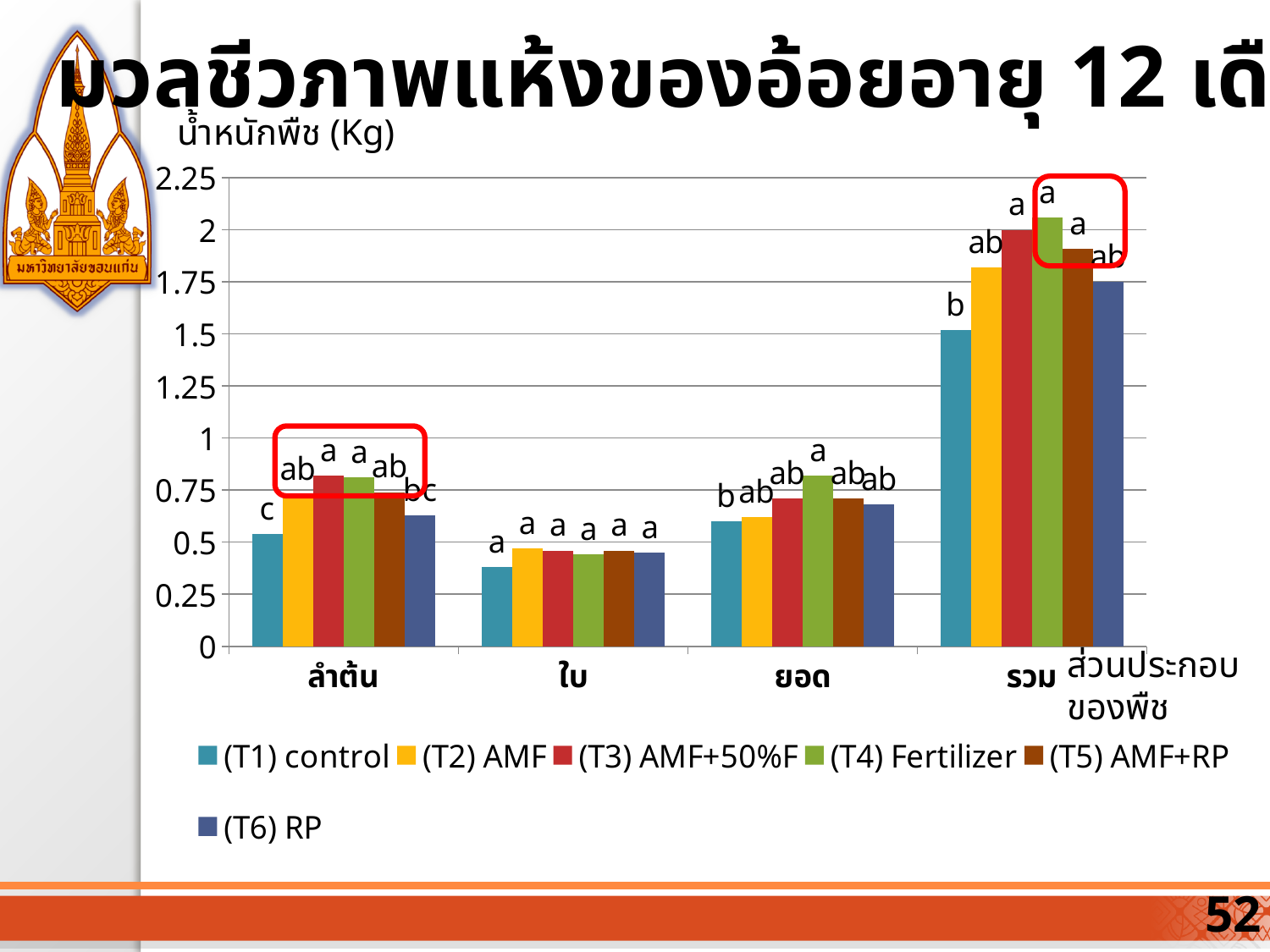
What kind of chart is shown on the slide? bar chart Is the value for (T1) control in the รวม category greater or less than 1.75? less In the ยอด category, which treatment has the highest value? (T4) Fertilizer Is the value for (T4) Fertilizer in the รวม category greater or less than 2? greater Which category has the tallest bars overall? รวม How many series does the legend list? 6 What is the label on the y axis? น้ำหนักพืช (Kg) How many categories are shown on the x axis? 4 Is the value for (T3) AMF+50%F in the รวม category greater or less than 1.75? greater In the รวม category, which treatment has the lowest value? (T1) control